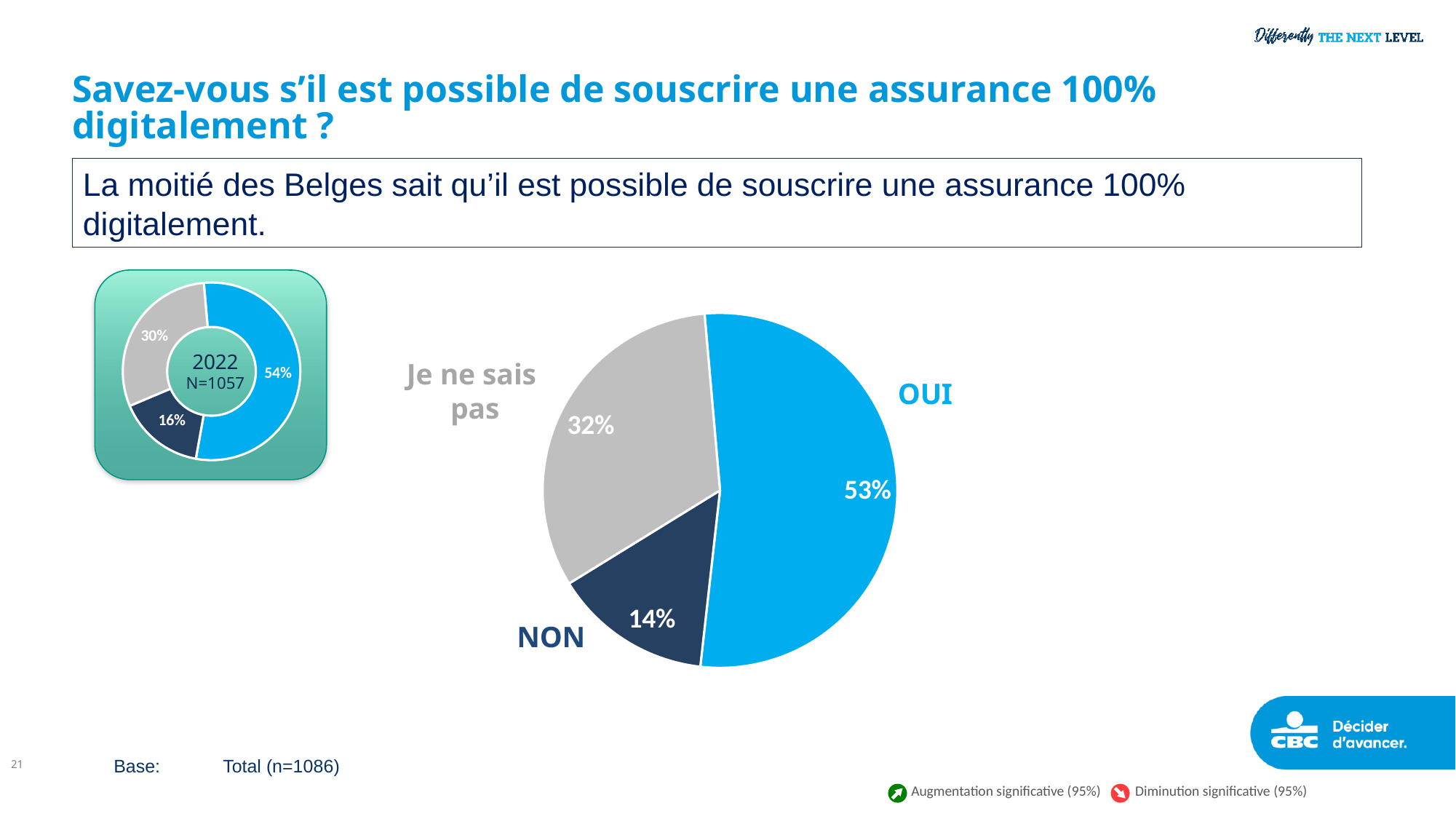
What year and sample size are written in the centre of the small donut chart on the left? 2022, N=1057 In the large pie chart, which category has the smallest slice? NON What kind of chart is the large chart in the centre of the slide? Pie chart In the small donut chart on the left, what percentage is shown for the dark navy segment? 16% In the large pie chart, what percentage is shown for OUI? 53% In the large pie chart, which is larger: NON or "Je ne sais pas"? Je ne sais pas In the large pie chart, which category has the largest slice? OUI How many slices does the large pie chart have? 3 In the small donut chart on the left, what percentage is shown for the blue segment? 54% In the large pie chart, what percentage is shown for "Je ne sais pas"? 32% In the large pie chart, what is the difference in percentage points between OUI and "Je ne sais pas"? 21 In the large pie chart, what percentage is shown for NON? 14%